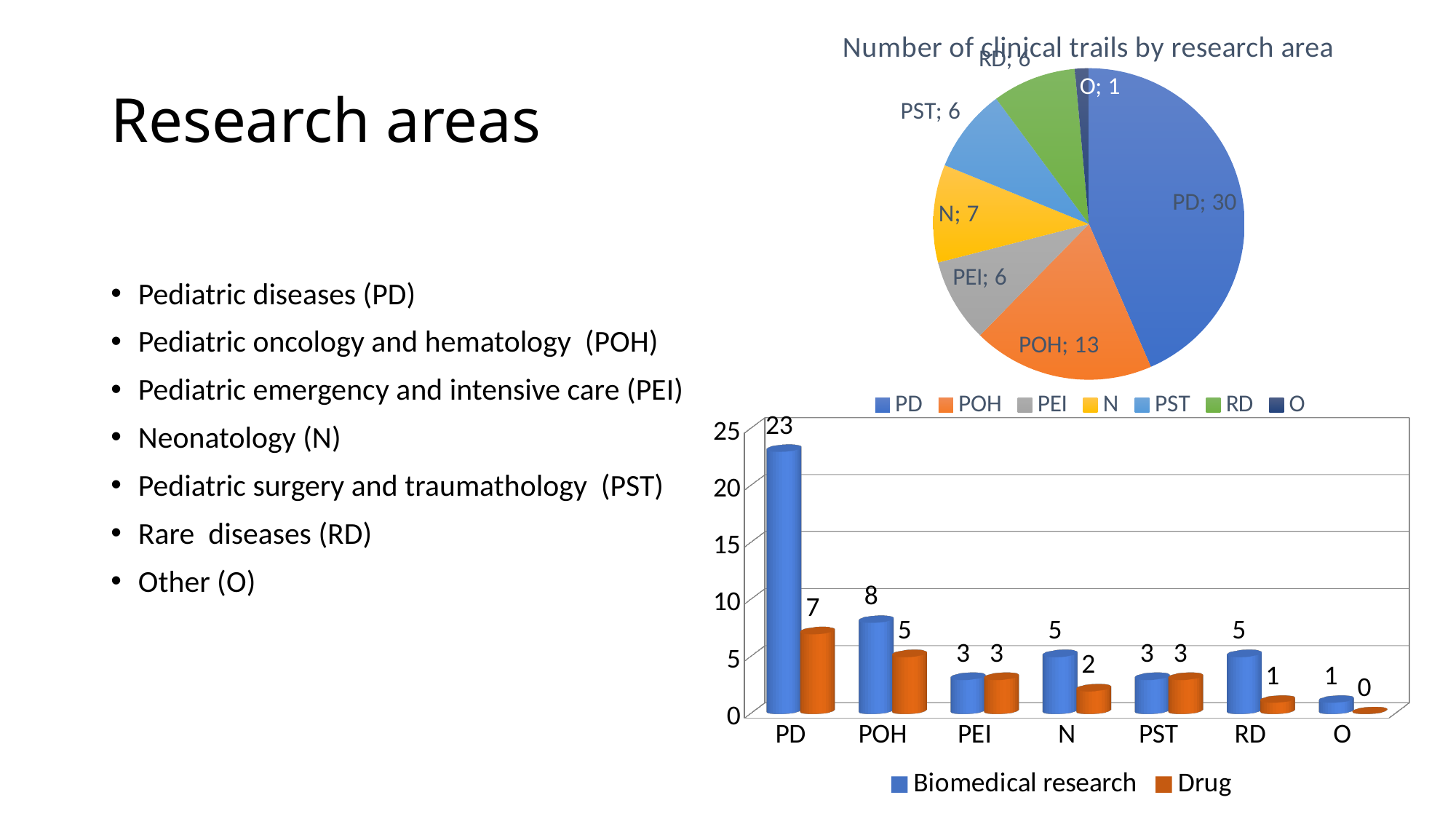
In the bar chart at the bottom right, what is the Biomedical research value for PD? 23 In the pie chart titled "Number of clinical trails by research area", what is the value for PD? 30 In the pie chart titled "Number of clinical trails by research area", which is larger, N or PEI? N What kind of chart is the one at the bottom right of the slide? Bar chart In the pie chart titled "Number of clinical trails by research area", how many slices are there? 7 In the bar chart at the bottom right, what is the Drug value for RD? 1 In the pie chart titled "Number of clinical trails by research area", what is the difference between the values for PD and POH? 17 In the bar chart at the bottom right, how many series does the legend list? 2 In the pie chart titled "Number of clinical trails by research area", which research area has the smallest slice? O In the bar chart at the bottom right, which series is shown in orange? Drug In the bar chart at the bottom right, which category has the highest Drug value? PD In the bar chart at the bottom right, what is the difference between the Biomedical research and Drug values for POH? 3